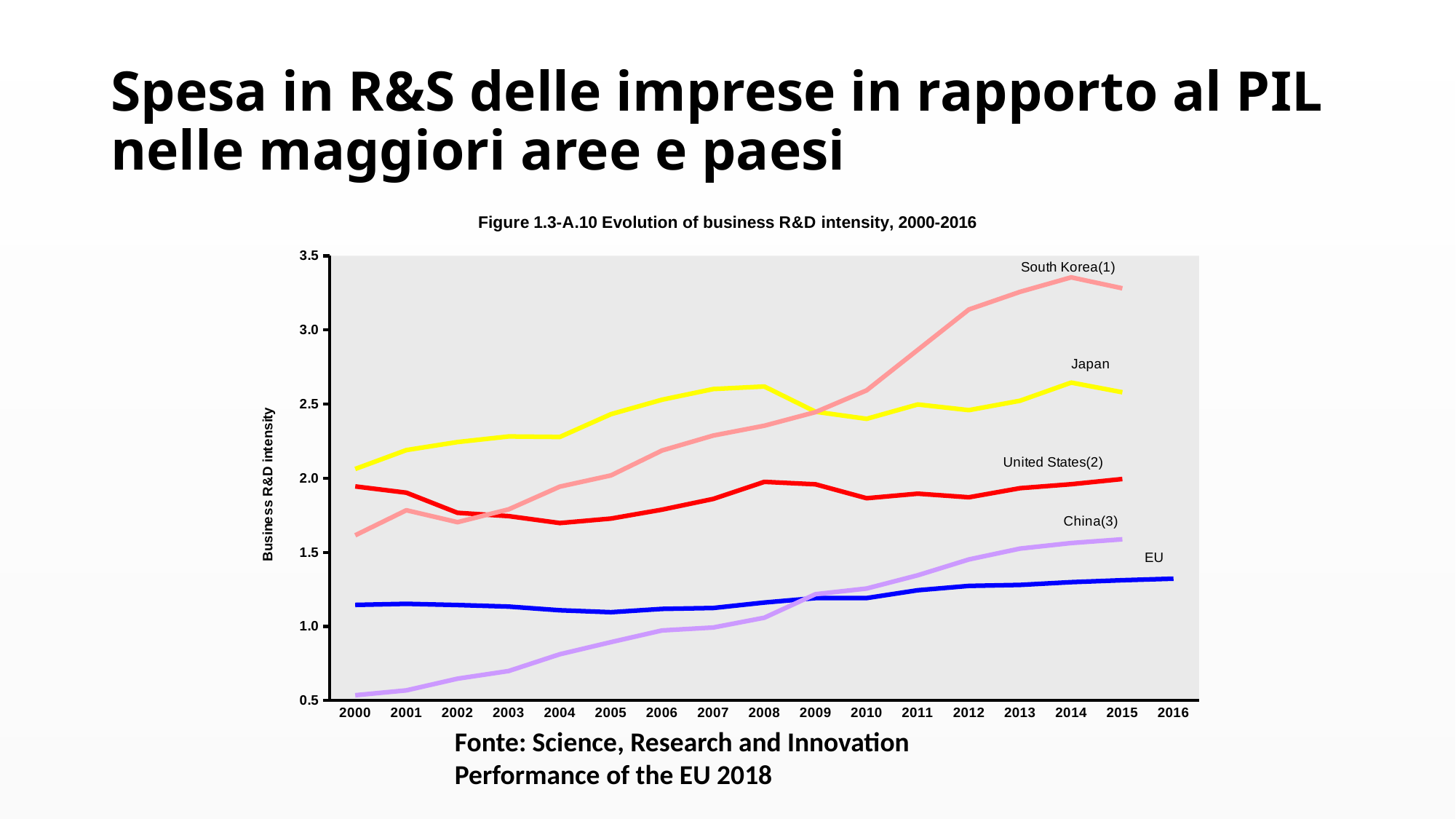
How many series (countries or areas) are plotted in the chart? 5 Is the value for South Korea(1) in 2014 greater or less than 3.0? greater Which series has the lowest business R&D intensity in 2015? EU Which series has the lowest business R&D intensity in 2000? China(3) Is the value for China(3) in 2000 greater or less than 1.0? less What kind of chart is shown on the slide? line chart Which series has the highest business R&D intensity in 2015? South Korea(1) In 2015, which is higher: China(3) or EU? China(3) In 2000, which is higher: Japan or South Korea(1)? Japan How many years are labelled on the x axis of the chart? 17 What is the title of the chart? Figure 1.3-A.10 Evolution of business R&D intensity, 2000-2016 Does the business R&D intensity of China(3) rise or fall from 2000 to 2015? rise